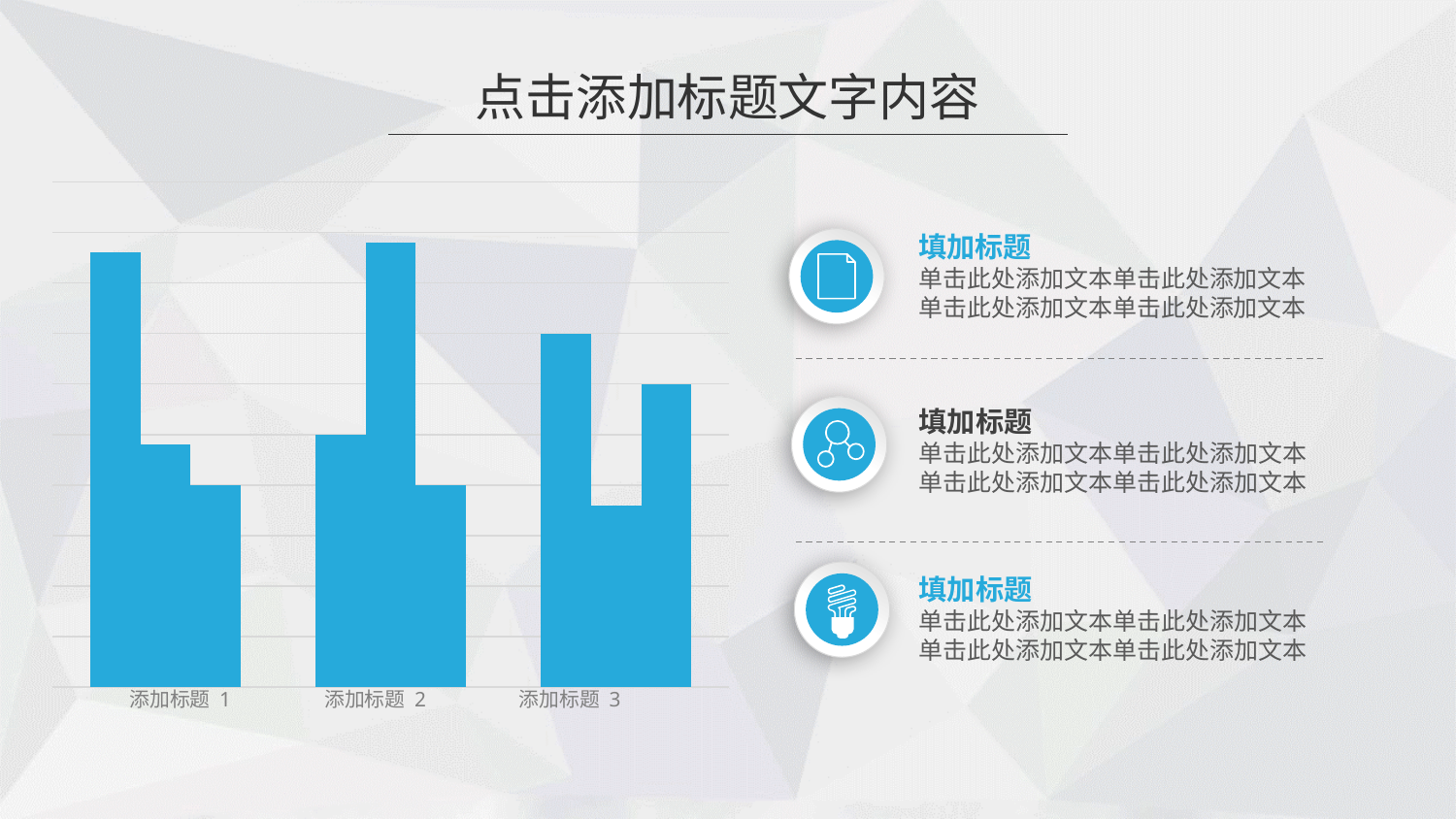
What colour are the bars in the bar chart? blue Does the bar chart display a legend? No How many bars are plotted for each category in the bar chart? 3 How many categories are shown on the x axis of the bar chart? 3 Within the category 添加标题 3, which bar is the shortest? the middle bar Within the category 添加标题 1, do the bars get taller or shorter from left to right? shorter What kind of chart is shown on the left of the slide? bar chart Within the category 添加标题 1, which bar is the tallest? the leftmost bar Is the middle bar of 添加标题 2 taller or shorter than the middle bar of 添加标题 3? taller Is the leftmost bar of 添加标题 1 taller or shorter than the leftmost bar of 添加标题 3? taller How many bars are plotted in total in the bar chart? 9 Which category has the shortest tallest bar in the bar chart? 添加标题 3